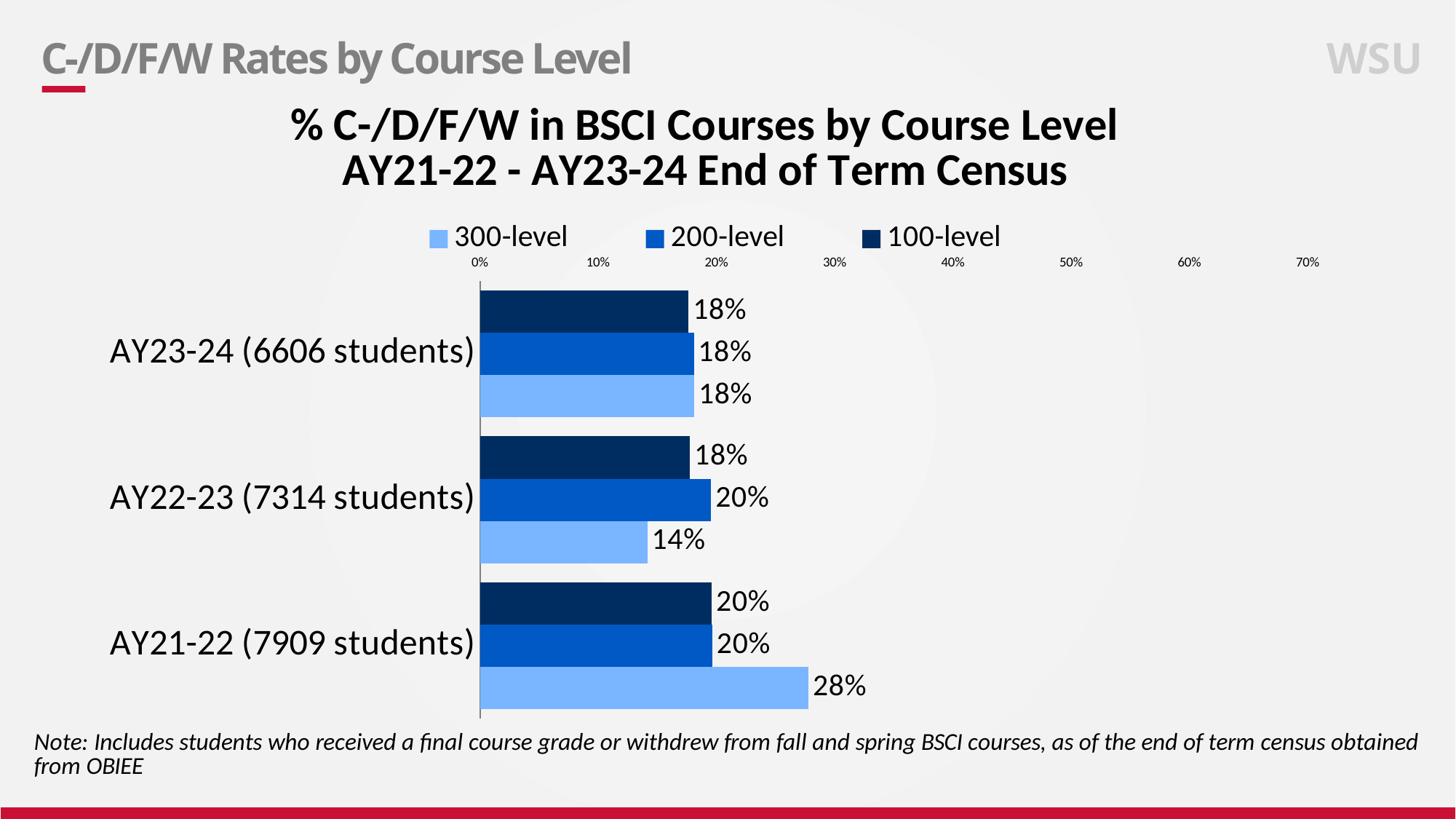
What is the C-/D/F/W rate for 300-level courses in AY22-23 (7314 students)? 14% Which academic year has the highest C-/D/F/W rate for 300-level courses? AY21-22 (7909 students) What is the difference between the 300-level rate in AY21-22 and the 300-level rate in AY22-23? 14% How many series does the legend list? 3 What is the C-/D/F/W rate for 100-level courses in AY23-24 (6606 students)? 18% What is the C-/D/F/W rate for 300-level courses in AY21-22 (7909 students)? 28% What is the C-/D/F/W rate for 200-level courses in AY22-23 (7314 students)? 20% Which is larger: the 200-level rate in AY22-23 or the 300-level rate in AY22-23? 200-level What kind of chart is shown on the slide? Bar chart Which academic year has the lowest C-/D/F/W rate for 300-level courses? AY22-23 (7314 students) Is the 300-level rate for AY21-22 greater or less than 20%? greater How many academic years are shown on the chart? 3